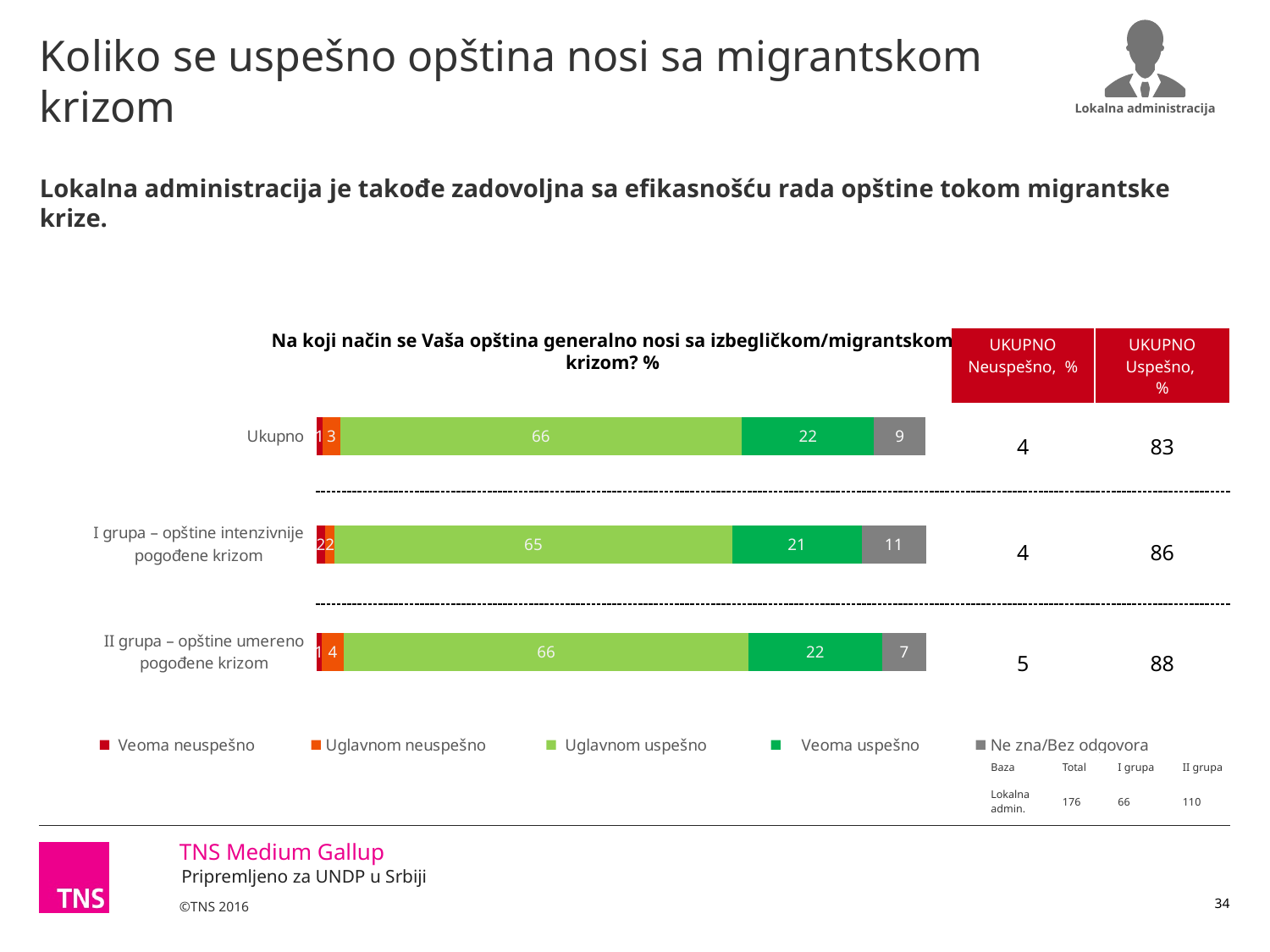
What is the value of "Uglavnom neuspešno" for "II grupa – opštine umereno pogođene krizom"? 4 What is the value of "Ne zna/Bez odgovora" for "II grupa – opštine umereno pogođene krizom"? 7 Which row has the lowest value for "Uglavnom uspešno"? I grupa – opštine intenzivnije pogođene krizom Is the "Veoma uspešno" value larger for "Ukupno" or for "I grupa – opštine intenzivnije pogođene krizom"? Ukupno How many categories (rows) are plotted in the chart? 3 What kind of chart is shown on the slide? Stacked bar chart What is the value of "Uglavnom uspešno" for the "Ukupno" row? 66 How many series does the chart legend list? 5 What is the difference between the "Ne zna/Bez odgovora" values for "I grupa" and "II grupa"? 4 Which row has the highest value for "Ne zna/Bez odgovora"? I grupa – opštine intenzivnije pogođene krizom In the "UKUPNO Uspešno, %" column, what is the value for "II grupa – opštine umereno pogođene krizom"? 88 What is the value of "Veoma uspešno" for "I grupa – opštine intenzivnije pogođene krizom"? 21